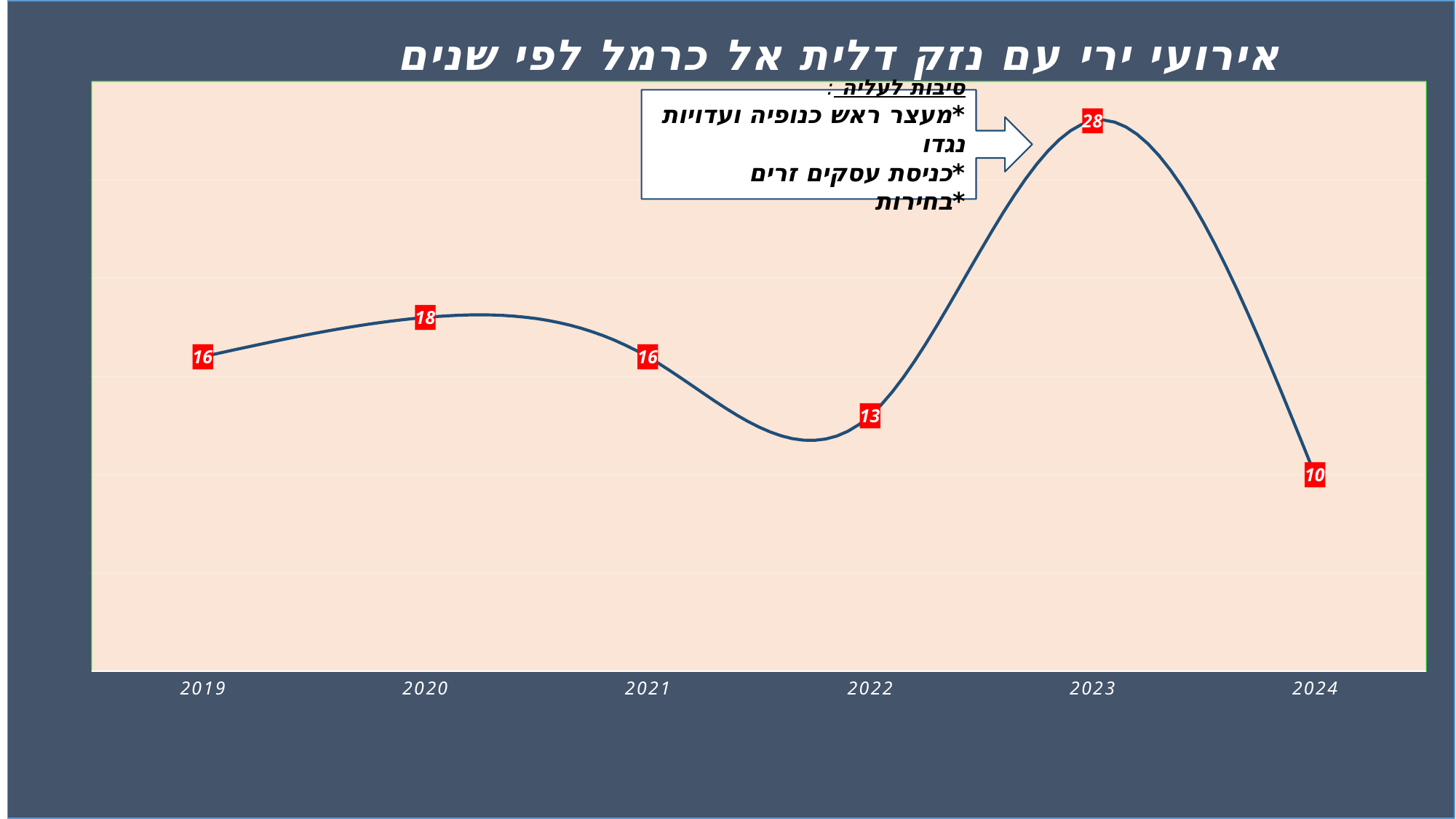
What is the difference between the values for 2020 and 2024? 8 What is the difference between the values for 2023 and 2022? 15 What is the value for 2020? 18 What is the value for 2022? 13 Which is larger, the value for 2021 or the value for 2022? 2021 How many years are plotted on the x axis? 6 What kind of chart is shown on the slide? line chart What is the value for 2019? 16 Which year has the lowest value? 2024 What is the value for 2023? 28 What is the value for 2024? 10 Which year has the highest value? 2023